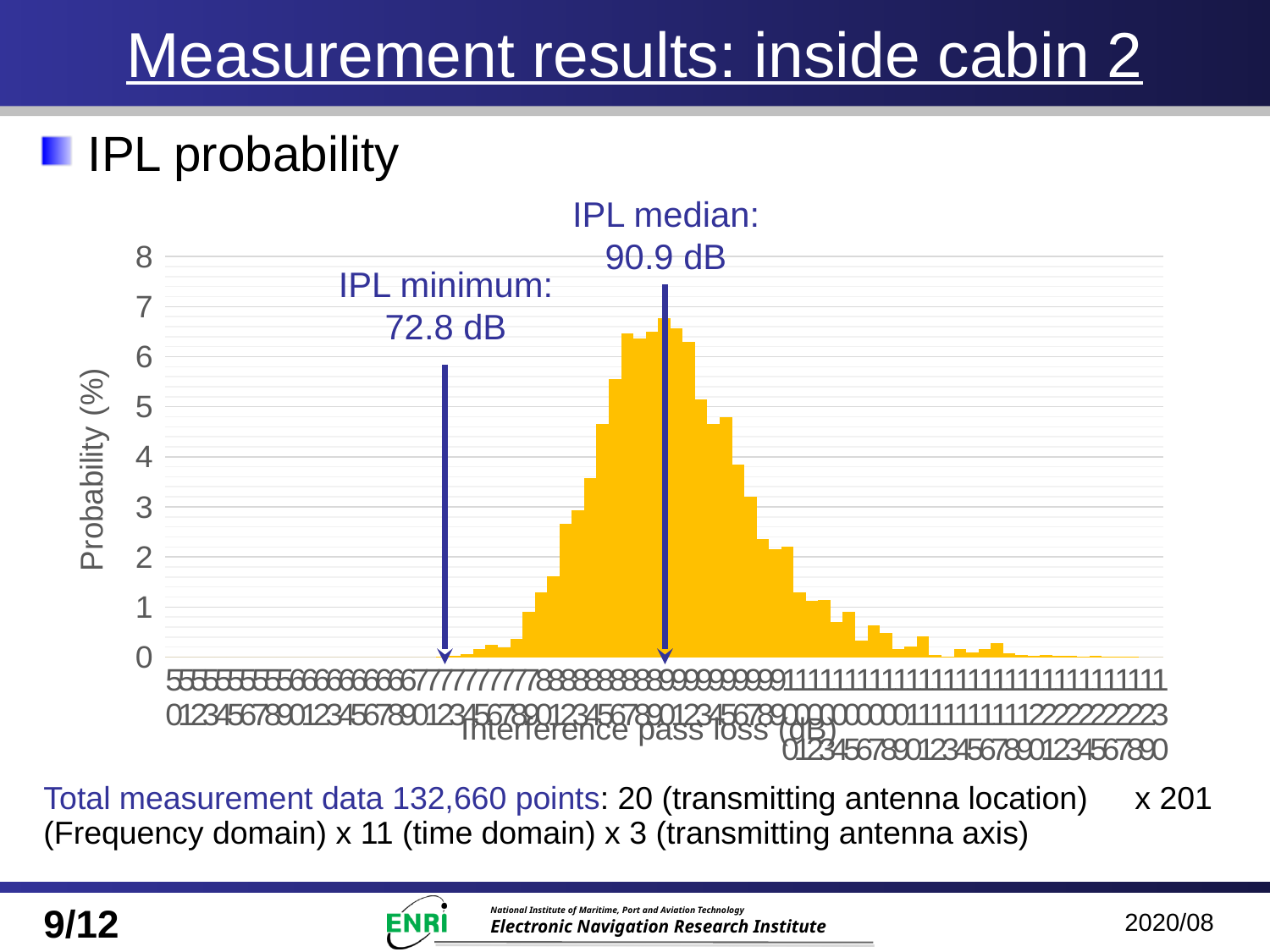
What kind of chart is shown on the slide? bar chart What colour are the bars in the chart? yellow Is the probability of the tallest bar greater or less than 8? less Is the bar at the IPL median arrow higher or lower than the bar at the IPL minimum arrow? higher What is the IPL median value annotated on the chart? 90.9 dB What is the title of the vertical axis? Probability (%) Moving right from the IPL median arrow, do the bar heights rise or fall? fall Moving right from the IPL minimum arrow toward the IPL median arrow, do the bar heights rise or fall? rise Is the probability of the tallest bar greater or less than 6? greater Is the probability at the IPL minimum arrow greater or less than 1? less What is the IPL minimum value annotated on the chart? 72.8 dB